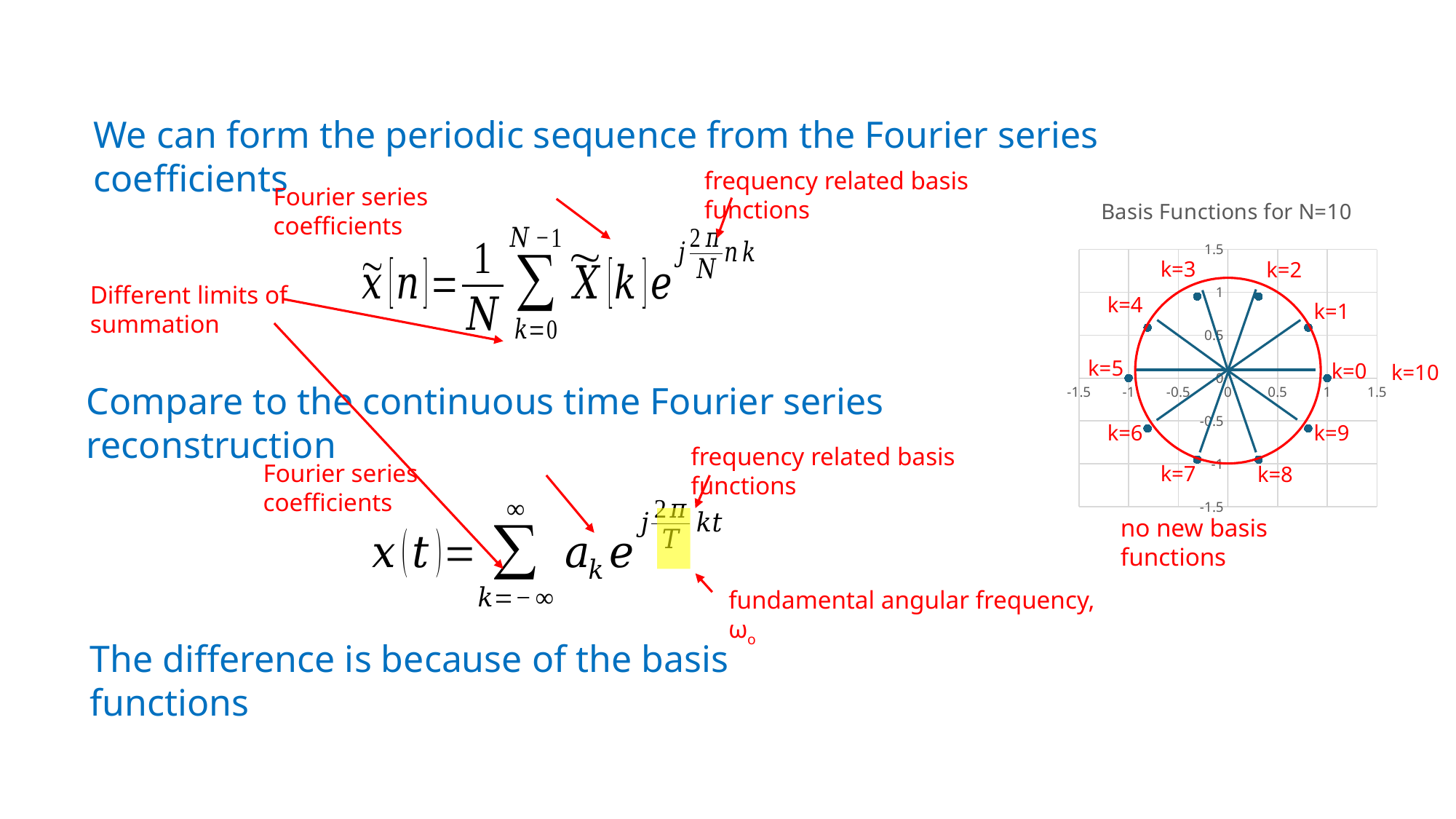
In the 'Basis Functions for N=10' chart, which point has a larger x value, k=1 or k=4? k=1 What is the title of the chart on the right of the slide? Basis Functions for N=10 In the 'Basis Functions for N=10' chart, which point has a larger y value, k=2 or k=9? k=2 In the 'Basis Functions for N=10' chart, which labelled point has the lowest x value? k=5 In the 'Basis Functions for N=10' chart, is the x value of the point k=1 greater or less than 0.5? greater In the 'Basis Functions for N=10' chart, which other label is placed at the same position as k=0? k=10 What kind of chart is 'Basis Functions for N=10'? scatter chart In the 'Basis Functions for N=10' chart, is the y value of the point k=2 greater or less than 0.5? greater In the 'Basis Functions for N=10' chart, how many distinct points are plotted on the circle? 10 In the 'Basis Functions for N=10' chart, is the y value of the point k=7 greater or less than -0.5? less In the 'Basis Functions for N=10' chart, what is the x value of the point labelled k=5? -1 In the 'Basis Functions for N=10' chart, what is the x value of the point labelled k=0? 1